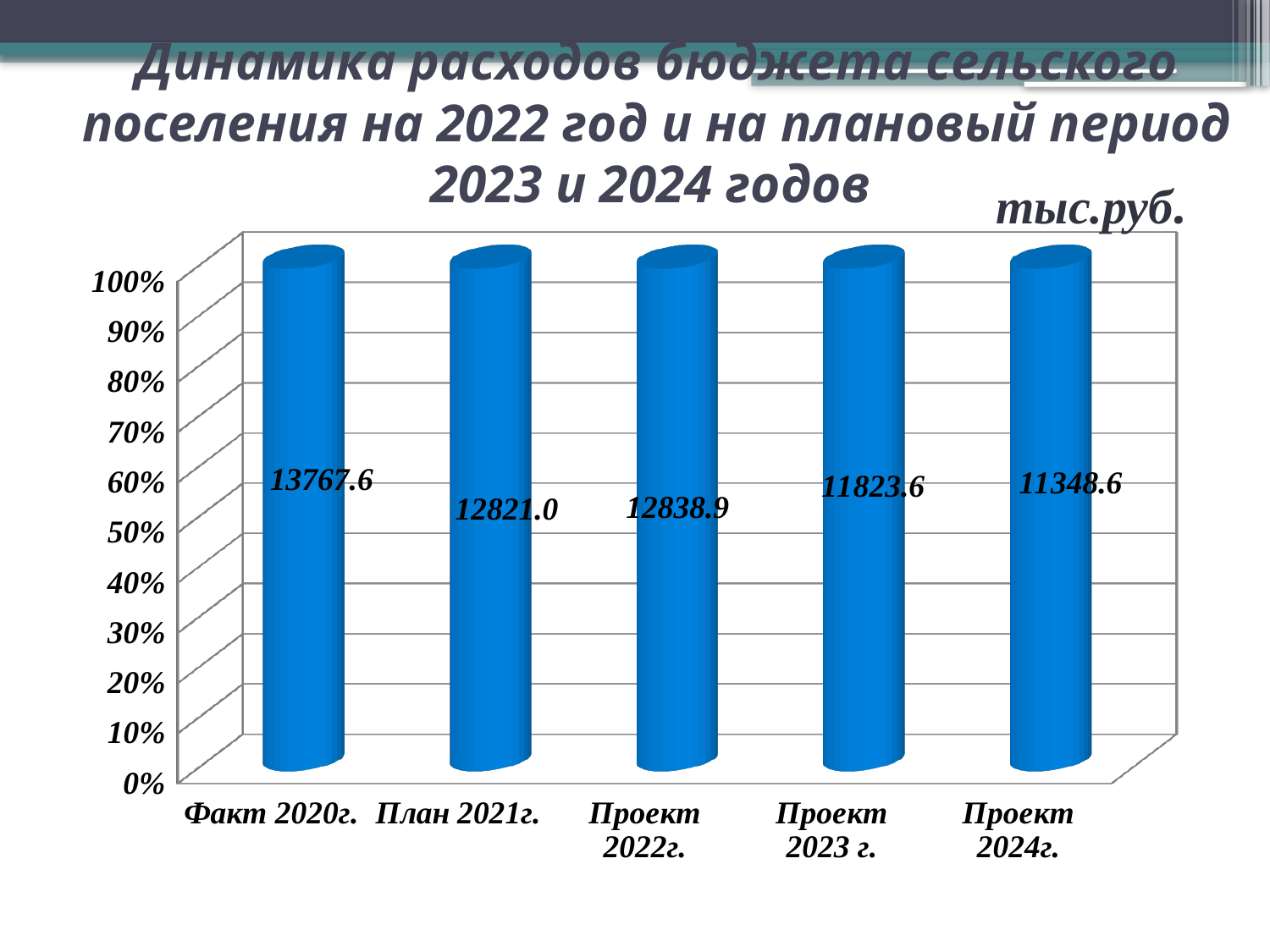
Which category has the highest labelled value? Факт 2020г. What kind of chart is shown on the slide? Bar chart How many categories are shown on the x axis? 5 What is the difference between the values for Проект 2023 г. and Проект 2024г.? 475.0 What is the data label for Факт 2020г.? 13767.6 Which has the larger labelled value, План 2021г. or Проект 2022г.? Проект 2022г. Which category has the lowest labelled value? Проект 2024г. In what units are the values on the chart expressed, according to the label at the top right? тыс.руб. What is the difference between the values for Факт 2020г. and План 2021г.? 946.6 What value is printed for Проект 2024г.? 11348.6 What value is shown for План 2021г.? 12821.0 What is the value labelled on the bar for Проект 2022г.? 12838.9